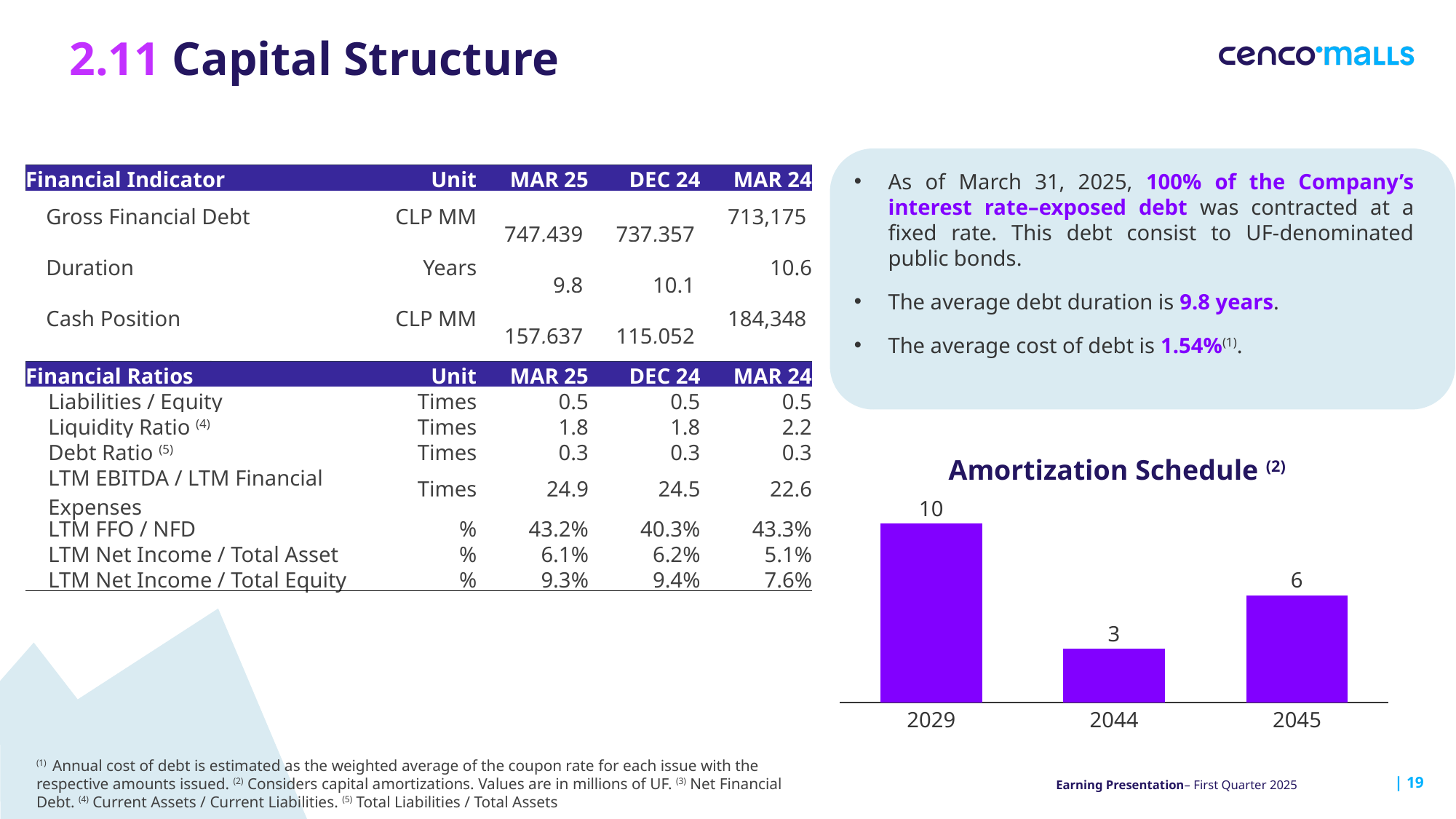
In the Amortization Schedule chart, what is the difference between the values for 2029 and 2045? 4 In the Amortization Schedule chart, what is the value for 2044? 3 In the Amortization Schedule chart, what is the value for 2029? 10 How many bars are shown in the Amortization Schedule chart? 3 What type of chart is the Amortization Schedule? Bar chart What is the title of the chart on the slide? Amortization Schedule In the Amortization Schedule chart, which is larger, the value for 2044 or the value for 2045? 2045 In the Amortization Schedule chart, which year has the highest value? 2029 In the Amortization Schedule chart, what is the value for 2045? 6 What colour are the bars in the Amortization Schedule chart? Purple In the Amortization Schedule chart, what is the difference between the values for 2045 and 2044? 3 In the Amortization Schedule chart, which year has the lowest value? 2044